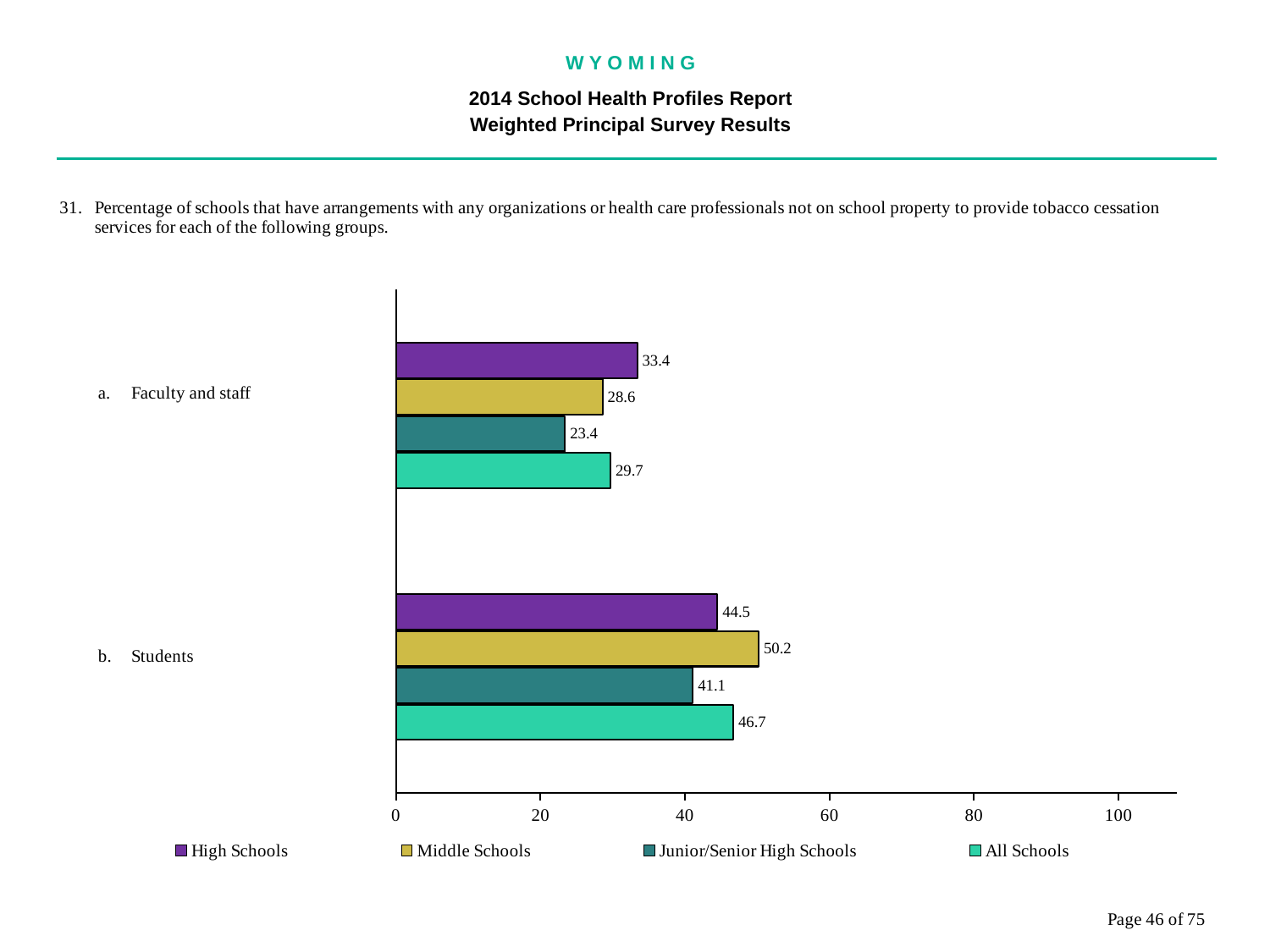
What is the value for Middle Schools in the Students category? 50.2 What is the value for All Schools in the Students category? 46.7 Which series has the highest value in the Students category? Middle Schools What is the value for High Schools in the Faculty and staff category? 33.4 Which series has the lowest value in the Faculty and staff category? Junior/Senior High Schools What kind of chart is shown on the slide? Bar chart What is the difference between the Middle Schools value and the High Schools value in the Students category? 5.7 Is the value for Junior/Senior High Schools in the Students category greater or less than 40? greater How many series does the legend list? 4 What is the value for Junior/Senior High Schools in the Faculty and staff category? 23.4 Which is larger in the Faculty and staff category: the High Schools value or the All Schools value? High Schools What colour are the bars for All Schools? Green